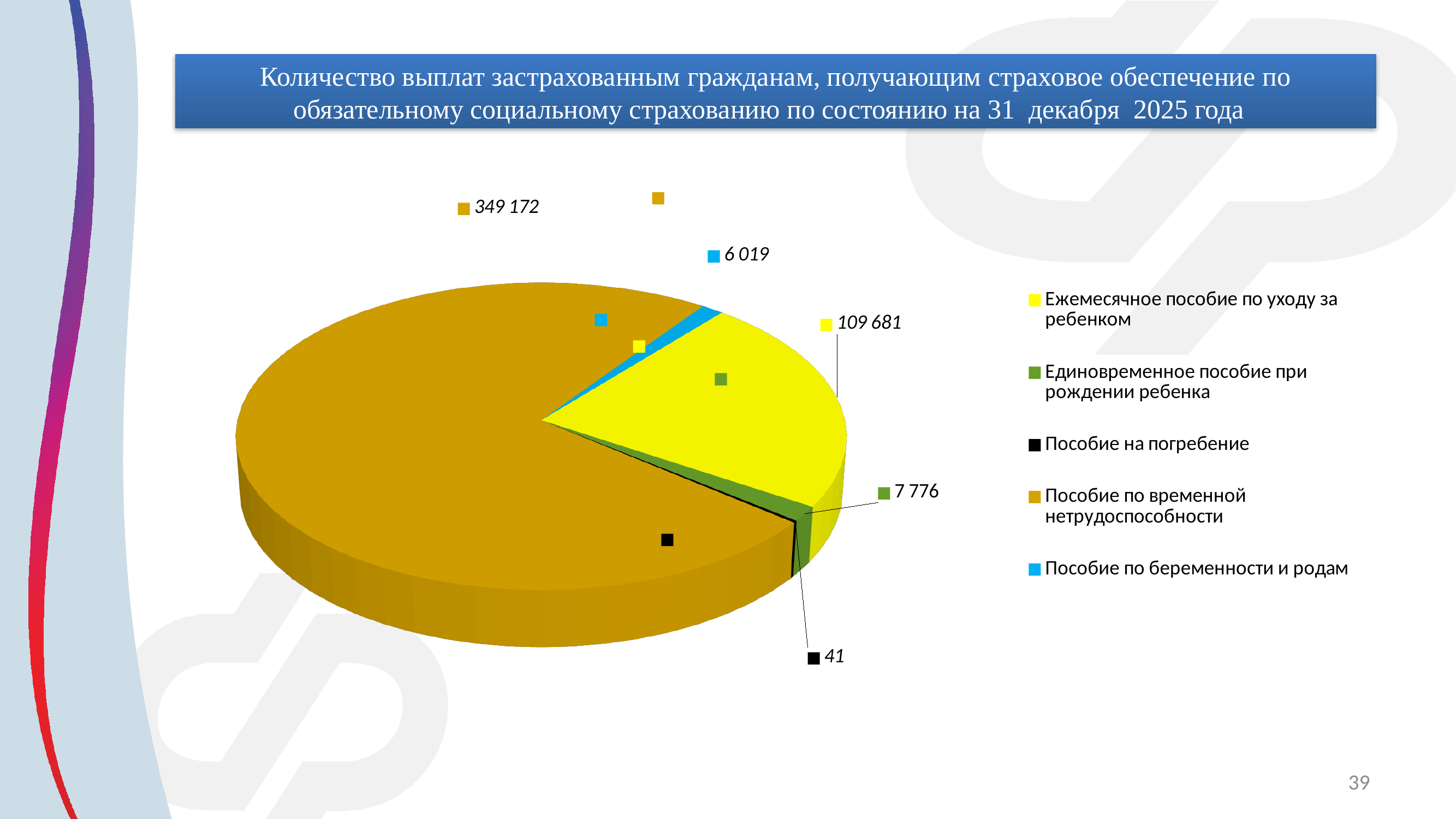
Which category has the smallest value? Пособие на погребение What colour is the slice for Пособие по беременности и родам? Blue What is the difference between the values for Пособие по временной нетрудоспособности and Ежемесячное пособие по уходу за ребенком? 239 491 What is the value for Ежемесячное пособие по уходу за ребенком? 109 681 How many categories does the pie chart have? 5 Which category has the largest value? Пособие по временной нетрудоспособности Which is larger: Единовременное пособие при рождении ребенка or Пособие по беременности и родам? Единовременное пособие при рождении ребенка What is the value for Единовременное пособие при рождении ребенка? 7 776 What kind of chart is shown on the slide? Pie chart What is the value for Пособие на погребение? 41 What is the value for Пособие по временной нетрудоспособности? 349 172 What is the value for Пособие по беременности и родам? 6 019